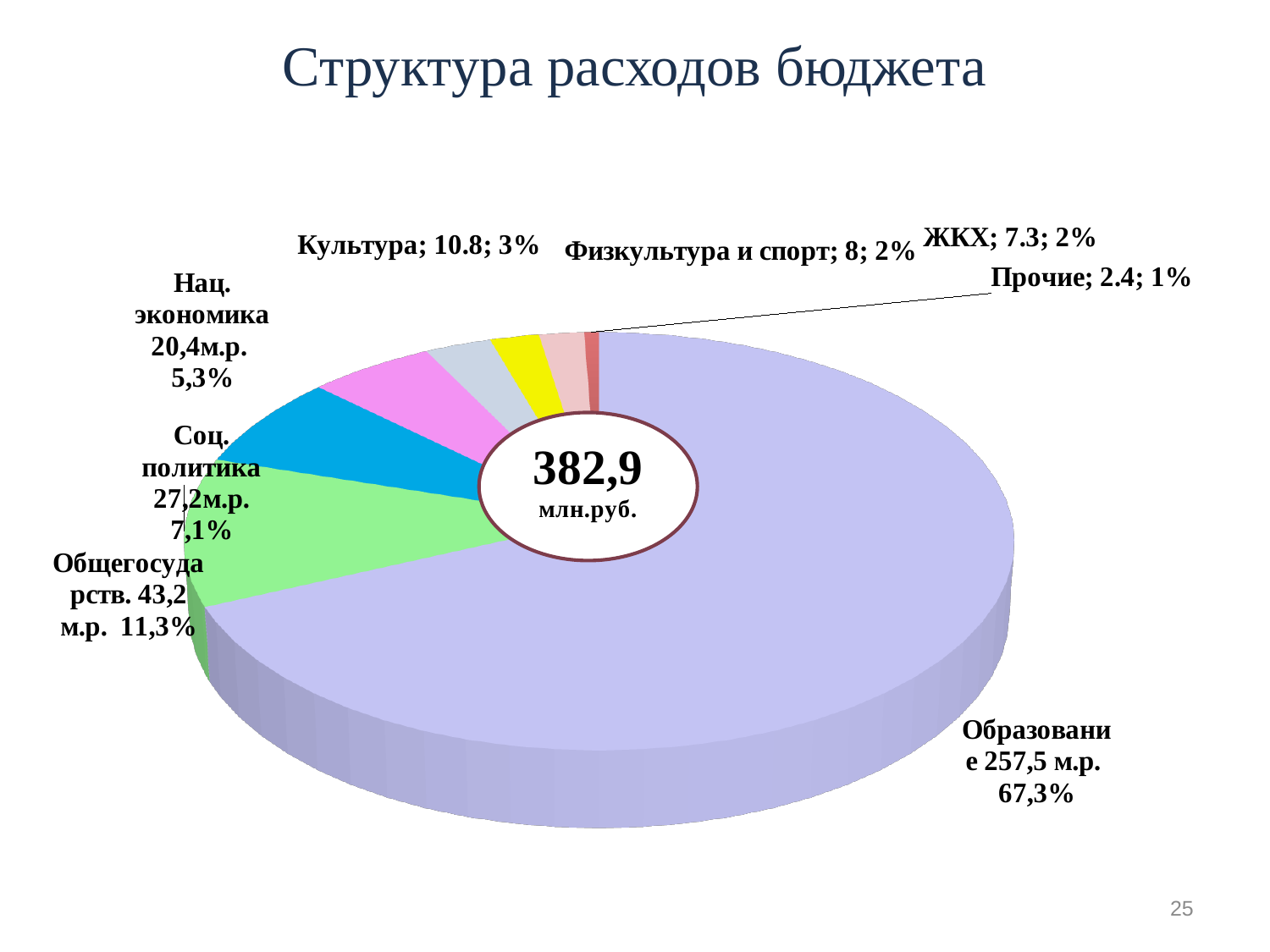
What total value is shown in the centre of the pie chart? 382,9 млн.руб. What is the value for Культура? 10.8 What is the title of the chart? Структура расходов бюджета What is the value for Образование in million roubles? 257,5 м.р. Which is larger, the value for Нац. экономика or the value for Соц. политика? Соц. политика What share of the pie does Соц. политика take? 7,1% What is the value for Общегосударств.? 43,2 м.р. Which category has the largest slice of the pie? Образование What kind of chart is shown on the slide? pie chart What share of the pie does Образование take? 67,3% How many categories are shown in the pie chart? 8 Which category has the smallest slice of the pie? Прочие